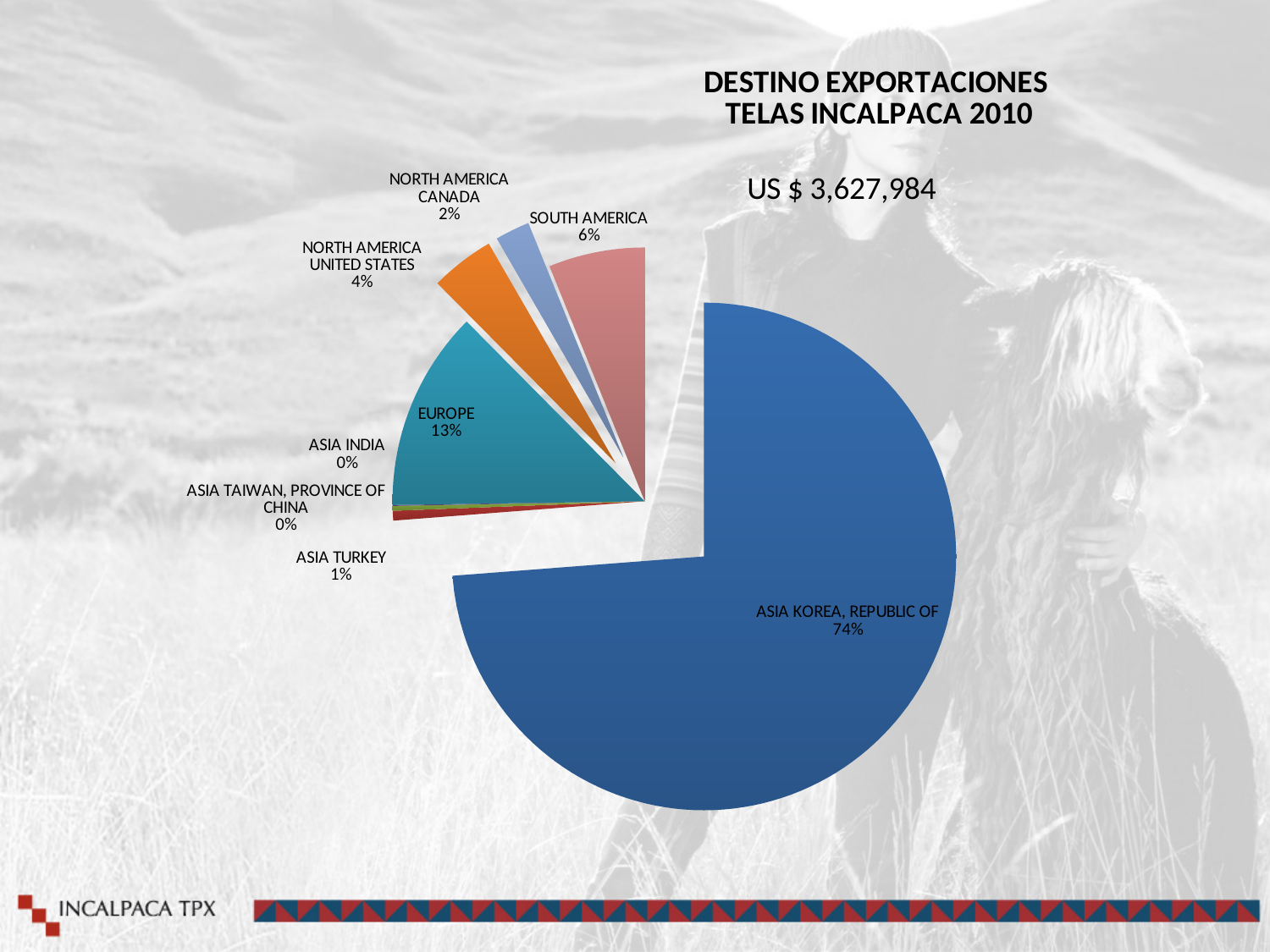
What is the difference in percentage points between EUROPE and SOUTH AMERICA? 7 What total export value is shown next to the chart title? US $ 3,627,984 What percentage is shown for ASIA TURKEY? 1% What type of chart is shown on the slide? pie chart What share of exports went to SOUTH AMERICA? 6% Which destination has the largest share of exports? ASIA KOREA, REPUBLIC OF What percentage is shown for NORTH AMERICA CANADA? 2% What percentage is shown for NORTH AMERICA UNITED STATES? 4% How many destination categories are labelled on the pie chart? 8 What share of exports went to EUROPE? 13% Which has a larger share, NORTH AMERICA UNITED STATES or NORTH AMERICA CANADA? NORTH AMERICA UNITED STATES What share of exports went to ASIA KOREA, REPUBLIC OF? 74%